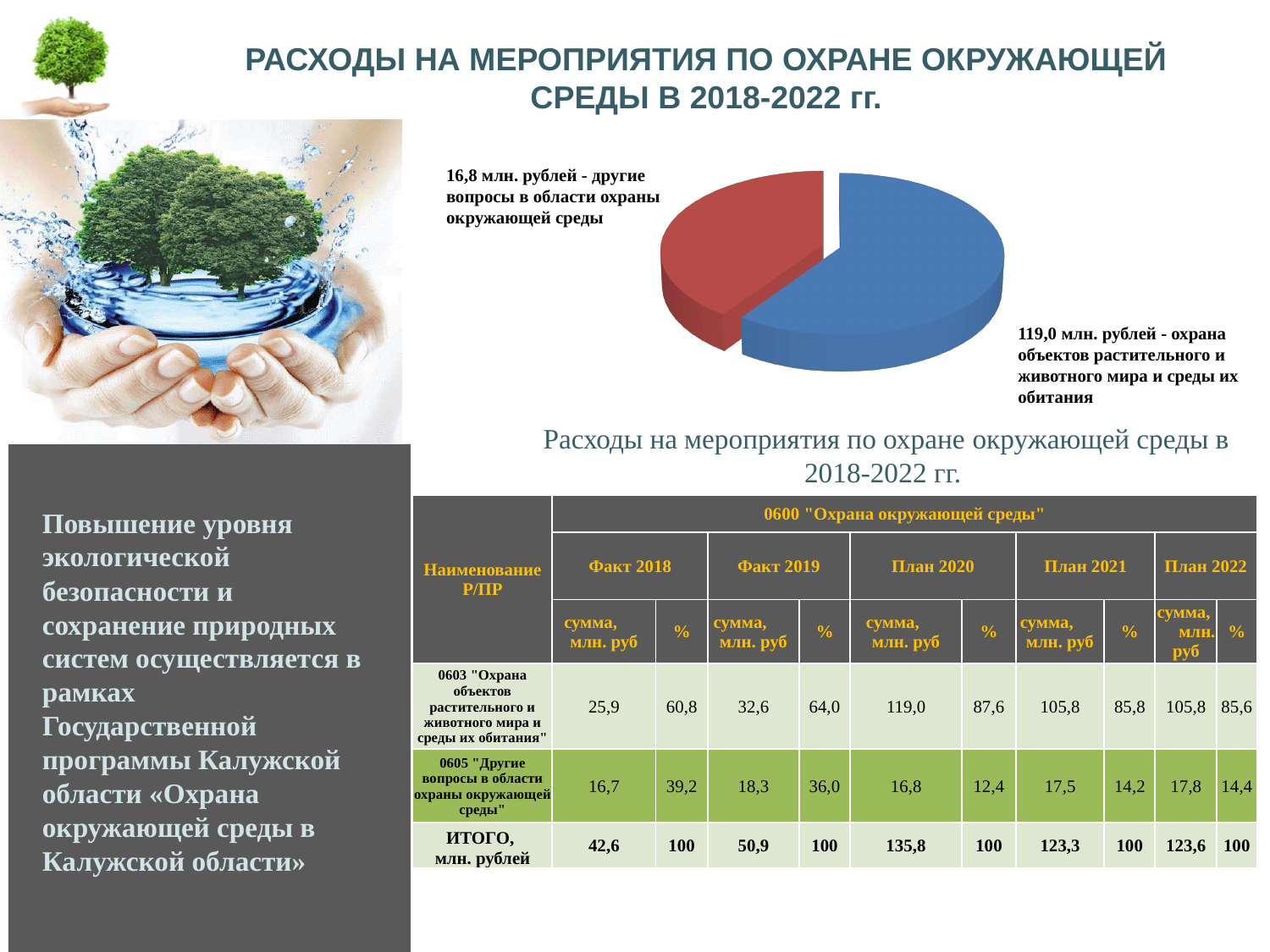
What is the total of the two values shown in the pie chart? 135,8 млн. рублей What value is labelled for the slice 'охрана объектов растительного и животного мира и среды их обитания' in the pie chart? 119,0 млн. рублей How many slices does the pie chart have? 2 What kind of chart is shown on the slide? pie chart What share of the pie chart does the slice for охрана объектов растительного и животного мира represent? 87,6% What colour is the slice for охрана объектов растительного и животного мира in the pie chart? blue Which slice of the pie chart is the smallest? другие вопросы в области охраны окружающей среды What value is labelled for the slice 'другие вопросы в области охраны окружающей среды' in the pie chart? 16,8 млн. рублей In the pie chart, what is the difference between the value for охрана объектов растительного и животного мира and the value for другие вопросы в области охраны окружающей среды? 102,2 млн. рублей In the pie chart, which is larger: the value for другие вопросы в области охраны окружающей среды or the value for охрана объектов растительного и животного мира? охрана объектов растительного и животного мира What colour is the slice for другие вопросы в области охраны окружающей среды in the pie chart? red Which slice of the pie chart is the largest? охрана объектов растительного и животного мира и среды их обитания